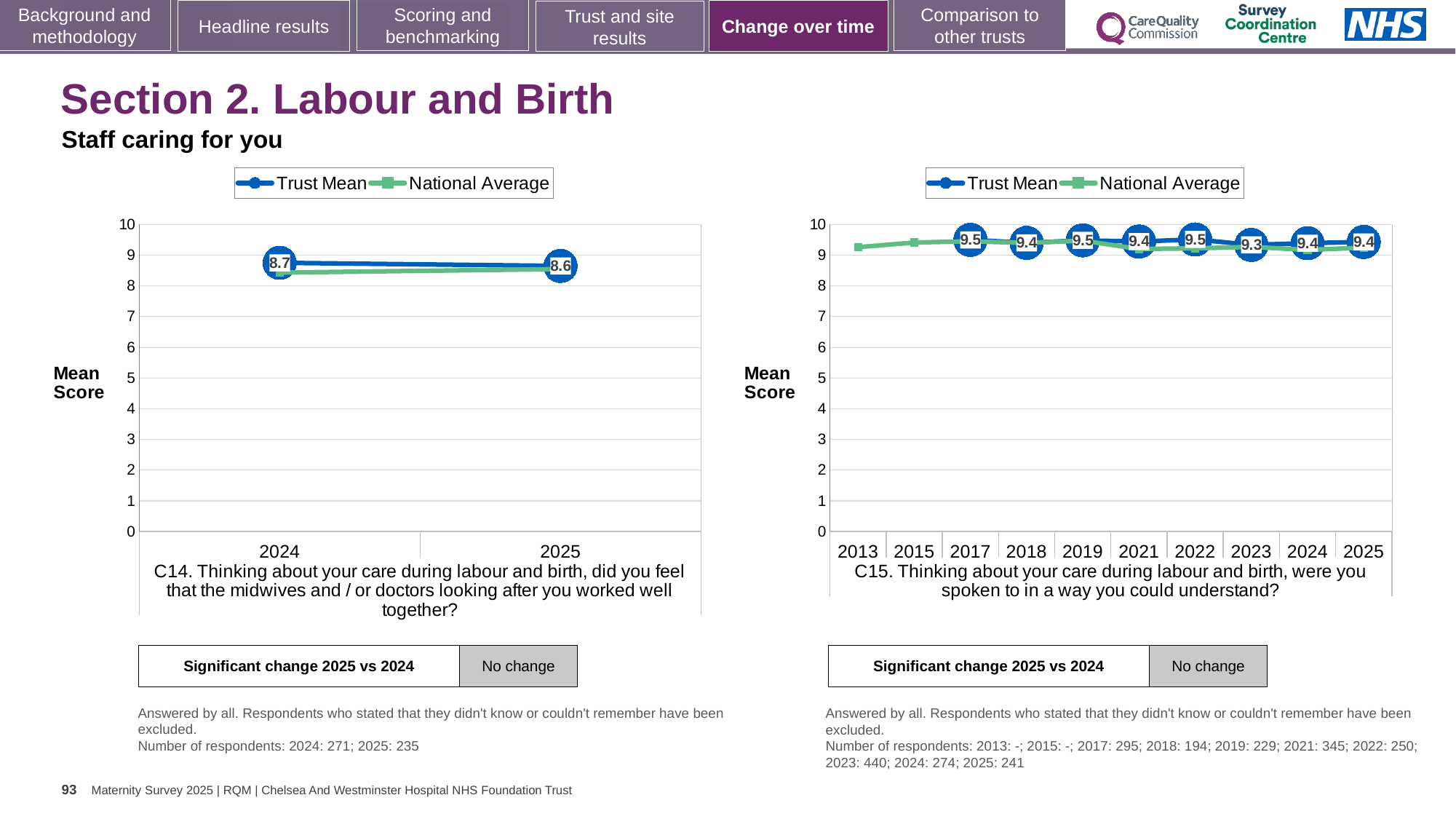
In the C15 chart on the right, what is the Trust Mean for 2025? 9.4 In the C15 chart on the right, which year has the lowest labelled Trust Mean? 2023 In the C14 chart on the left, what is the Trust Mean for 2025? 8.6 In the C15 chart on the right, how many years are shown on the x axis? 10 In the C15 chart on the right, what is the difference between the Trust Mean for 2022 and 2023? 0.2 In the C14 chart on the left, what is the Trust Mean for 2024? 8.7 In the C14 chart on the left, what is the difference between the Trust Mean for 2024 and 2025? 0.1 In the C15 chart on the right, what is the Trust Mean for 2023? 9.3 In the C14 chart on the left, does the Trust Mean rise or fall from 2024 to 2025? fall What kind of chart is the C15 chart on the right? line chart How many series does the legend of the C14 chart on the left list? 2 In the C15 chart on the right, is the National Average for 2013 greater or less than 8? greater